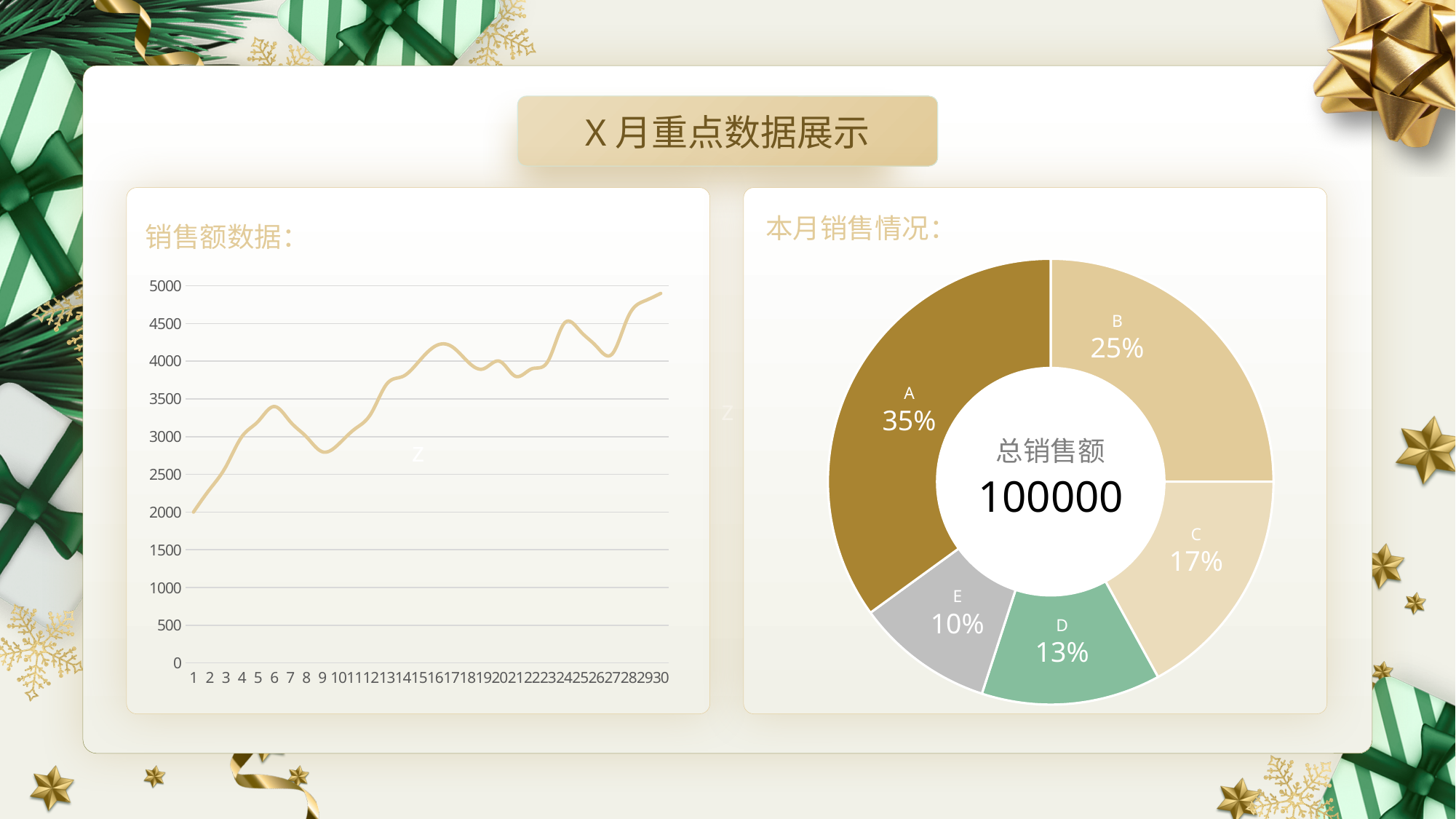
In the 本月销售情况 chart, which segment has the smallest share? E What total value is shown in the centre of the 本月销售情况 chart? 100000 In the 销售额数据 line chart, is the value at point 30 greater or less than 4500? greater How many segments does the 本月销售情况 chart have? 5 In the 本月销售情况 chart, which segment has the largest share? A What kind of chart is the left chart titled 销售额数据? line chart In the 本月销售情况 chart, which is larger, the share of C or the share of D? C In the 本月销售情况 chart, what is the difference between the shares of A and B? 10% In the 销售额数据 line chart, do the values generally rise or fall from point 1 to point 30? rise In the 本月销售情况 chart, what percentage does segment A represent? 35% What kind of chart is the right chart titled 本月销售情况? doughnut chart In the 本月销售情况 chart, what percentage does segment D represent? 13%